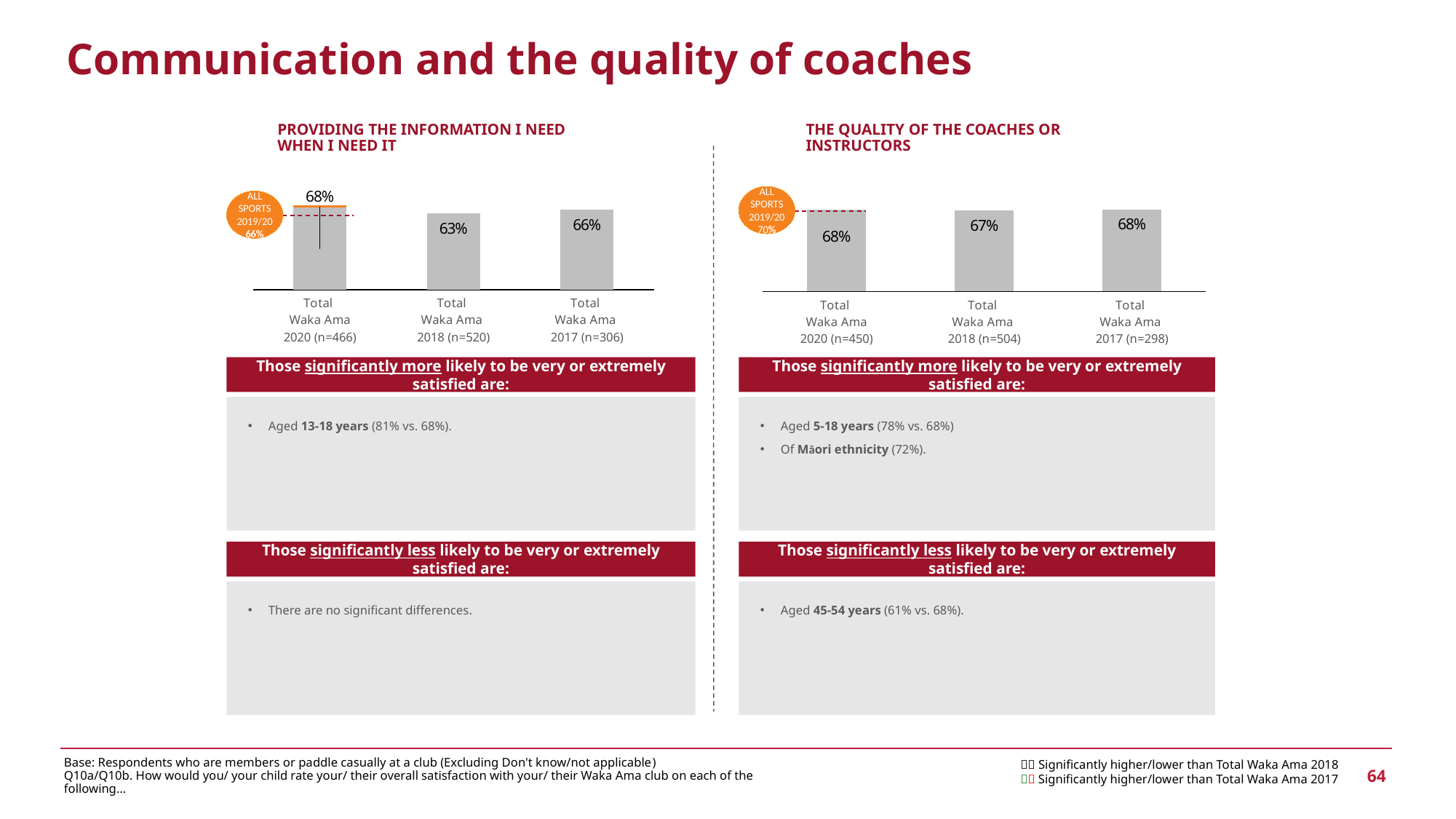
In the 'The quality of the coaches or instructors' chart, what is the All Sports 2019/20 benchmark value shown in the orange circle? 70% In the 'Providing the information I need when I need it' chart, which category has the lowest value? Total Waka Ama 2018 (n=520) What kind of chart is used for 'The quality of the coaches or instructors'? Bar chart In the 'The quality of the coaches or instructors' chart, what is the difference between the 2020 and 2018 values? 1 percentage point In the 'The quality of the coaches or instructors' chart, which category has the lowest value? Total Waka Ama 2018 (n=504) In the 'The quality of the coaches or instructors' chart, what is the value for Total Waka Ama 2018 (n=504)? 67% In the 'Providing the information I need when I need it' chart, what is the All Sports 2019/20 benchmark value shown in the orange circle? 66% In the 'Providing the information I need when I need it' chart, what is the difference between the 2020 and 2018 values? 5 percentage points In the 'Providing the information I need when I need it' chart, how many bars are plotted? 3 In the 'Providing the information I need when I need it' chart, what is the value for Total Waka Ama 2020 (n=466)? 68% In the 'Providing the information I need when I need it' chart, what is the value for Total Waka Ama 2018 (n=520)? 63% In the 'The quality of the coaches or instructors' chart, what is the value for Total Waka Ama 2017 (n=298)? 68%